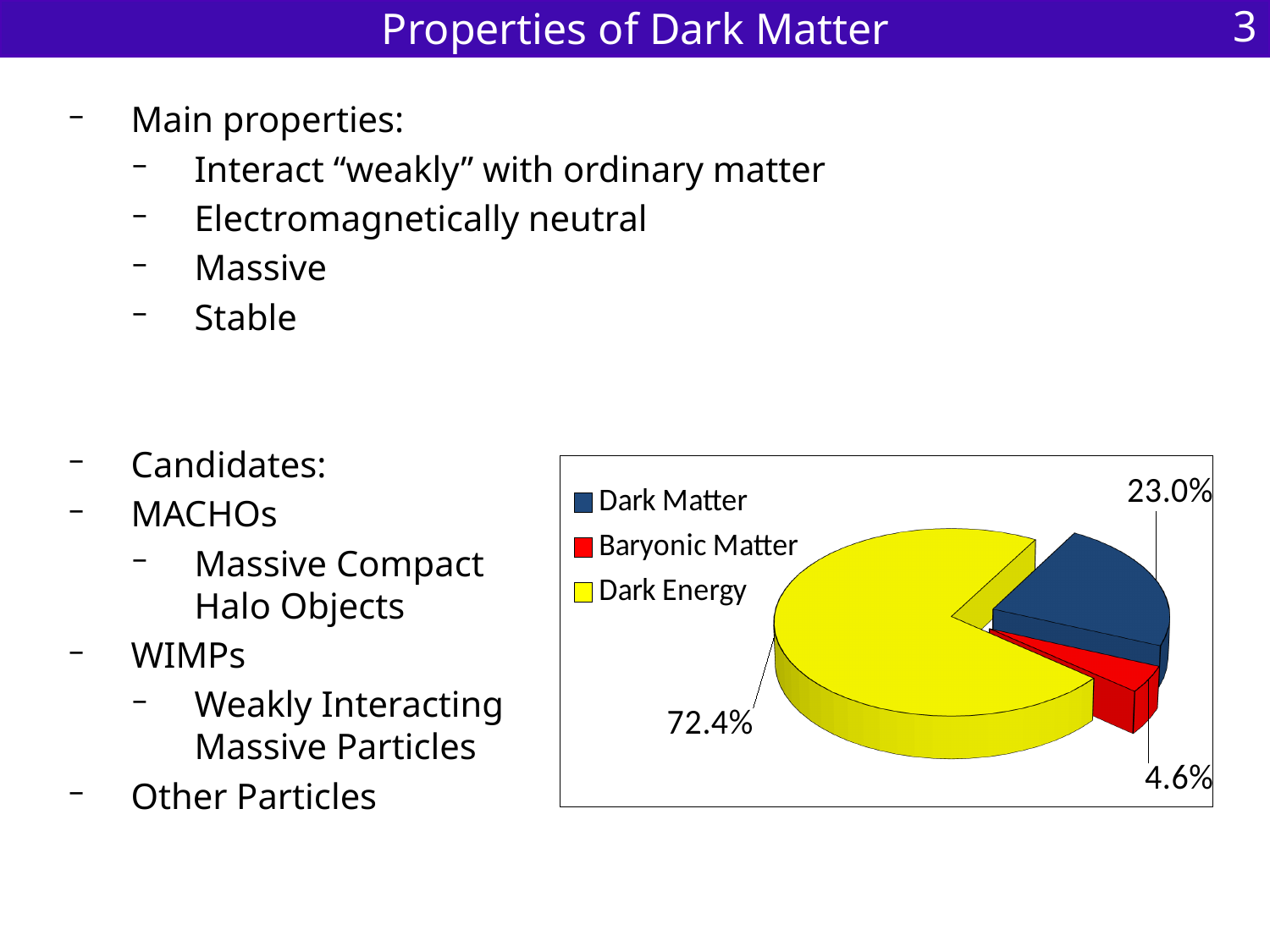
Which category is shown in red in the legend? Baryonic Matter What kind of chart is shown on the slide? pie chart What is the difference in percentage points between the Dark Energy and Dark Matter slices? 49.4 Which category has the smallest slice of the pie? Baryonic Matter What share of the pie does Baryonic Matter represent? 4.6% Which category has the largest slice of the pie? Dark Energy Which is larger, the Dark Matter slice or the Baryonic Matter slice? Dark Matter What colour is the Dark Energy slice in the pie chart? yellow What share of the pie does Dark Energy represent? 72.4% What share of the pie does Dark Matter represent? 23.0% How many categories does the pie chart show? 3 What is the difference in percentage points between the Dark Matter and Baryonic Matter slices? 18.4